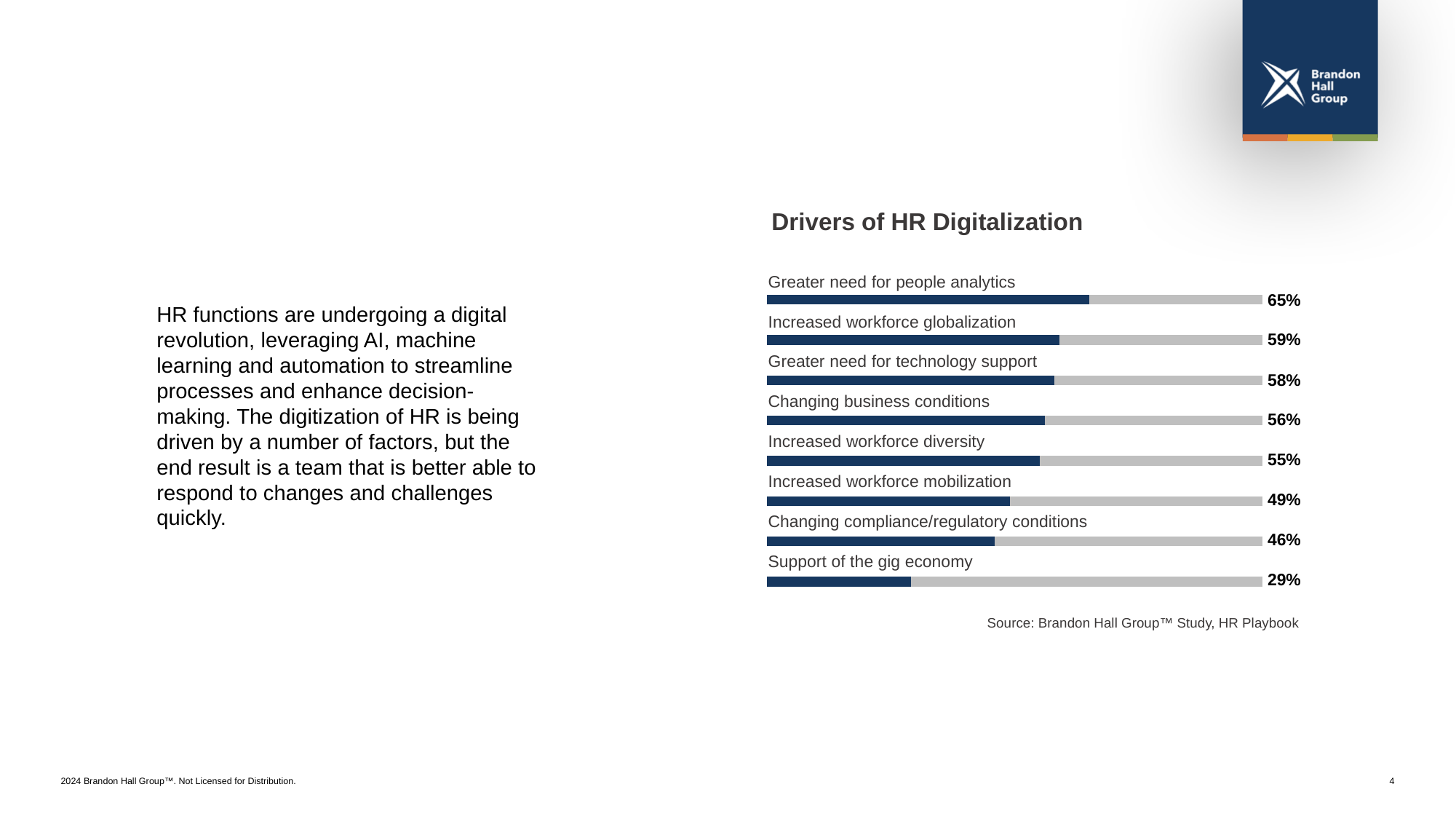
What is the value for Changing compliance/regulatory conditions? 46% What is the difference between Increased workforce diversity and Increased workforce mobilization? 6% How many drivers are shown in the chart? 8 What kind of chart is shown on the slide? Bar chart What is the title of the chart? Drivers of HR Digitalization Which driver has the lowest value? Support of the gig economy Which is larger, Changing business conditions or Changing compliance/regulatory conditions? Changing business conditions What is the value for Greater need for people analytics? 65% What is the difference between Greater need for people analytics and Support of the gig economy? 36% What is the value for Increased workforce globalization? 59% What is the value for Support of the gig economy? 29% Which driver has the highest value? Greater need for people analytics